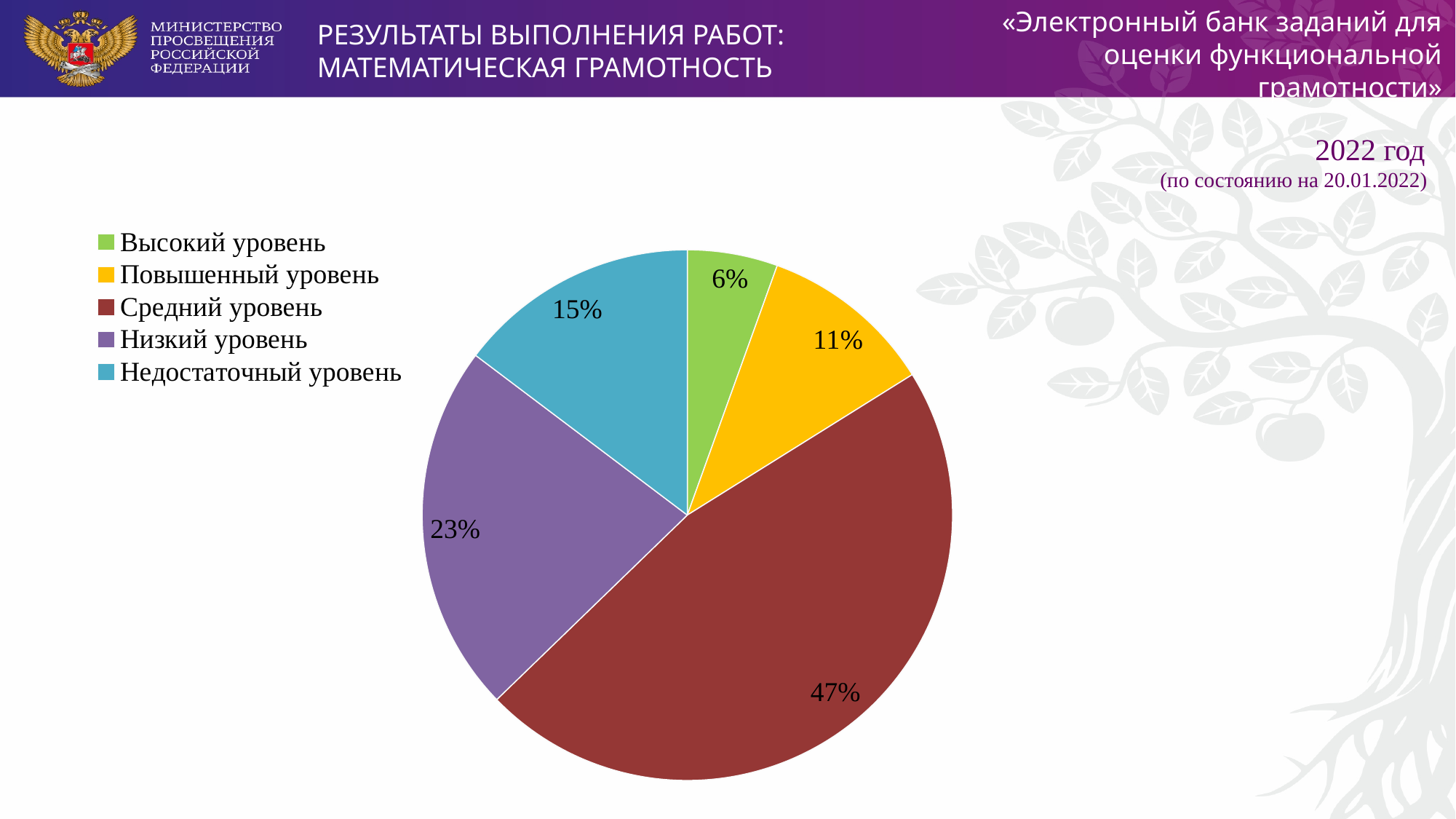
What share of the pie is labelled Недостаточный уровень? 15% What is the difference in percentage points between Низкий уровень and Недостаточный уровень? 8 How many slices does the pie chart have? 5 What share of the pie is labelled Высокий уровень? 6% Which is larger, the slice for Повышенный уровень or the slice for Недостаточный уровень? Недостаточный уровень Which category has the largest slice of the pie? Средний уровень What colour is the slice for Средний уровень? dark red Which category has the smallest slice of the pie? Высокий уровень What kind of chart is shown on the slide? pie chart What share of the pie is labelled Низкий уровень? 23% What share of the pie is labelled Средний уровень? 47% What share of the pie is labelled Повышенный уровень? 11%